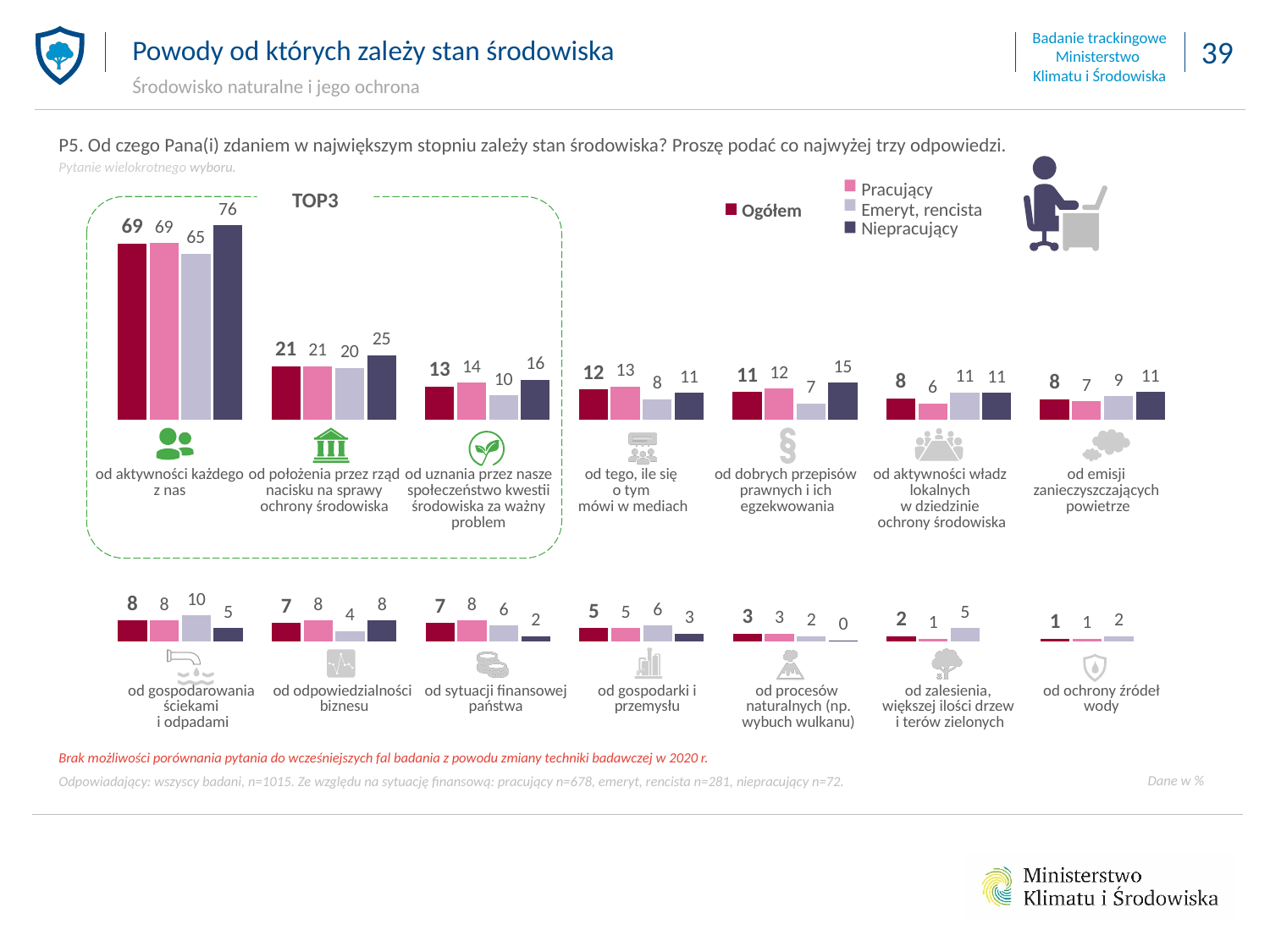
What is the Emeryt, rencista value for "od dobrych przepisów prawnych i ich egzekwowania"? 7 Which three categories are grouped inside the dashed TOP3 box? od aktywności każdego z nas; od położenia przez rząd nacisku na sprawy ochrony środowiska; od uznania przez nasze społeczeństwo kwestii środowiska za ważny problem What is the Ogółem value for "od aktywności każdego z nas"? 69 How many categories (reasons) are shown in the chart? 14 What kind of chart is shown on the slide? bar chart What is the Pracujący value for "od sytuacji finansowej państwa"? 8 Which category has the lowest Ogółem value? od ochrony źródeł wody How many series does the legend list? 4 What is the Niepracujący value for "od położenia przez rząd nacisku na sprawy ochrony środowiska"? 25 For "od aktywności władz lokalnych w dziedzinie ochrony środowiska", which is larger: the Pracujący value or the Emeryt, rencista value? Emeryt, rencista What is the difference between the Niepracujący and Emeryt, rencista values for "od aktywności każdego z nas"? 11 Which category has the highest Ogółem value? od aktywności każdego z nas